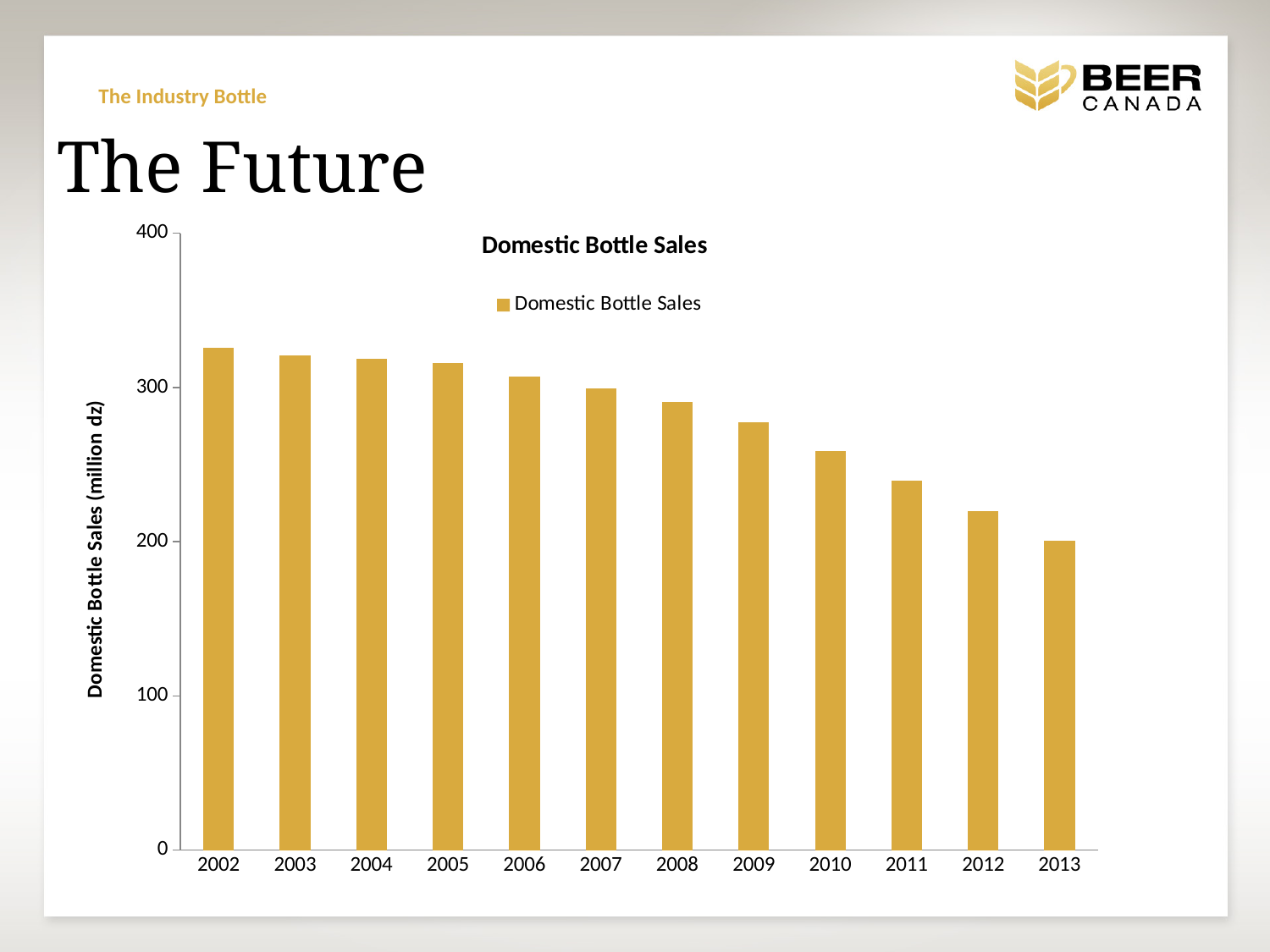
What is the title of the chart? Domestic Bottle Sales What is the label on the vertical axis of the chart? Domestic Bottle Sales (million dz) Which year has the lowest domestic bottle sales? 2013 Is the value for 2010 greater or less than 300? less Is the value for 2012 greater or less than 200? greater How many years are plotted on the x axis of the Domestic Bottle Sales chart? 12 Is the value for 2002 greater or less than 300? greater How many series does the legend of the Domestic Bottle Sales chart list? 1 Which year has the highest domestic bottle sales? 2002 Do domestic bottle sales rise or fall from 2002 to 2013? fall Which year has larger domestic bottle sales, 2004 or 2011? 2004 What kind of chart is shown on the slide? bar chart